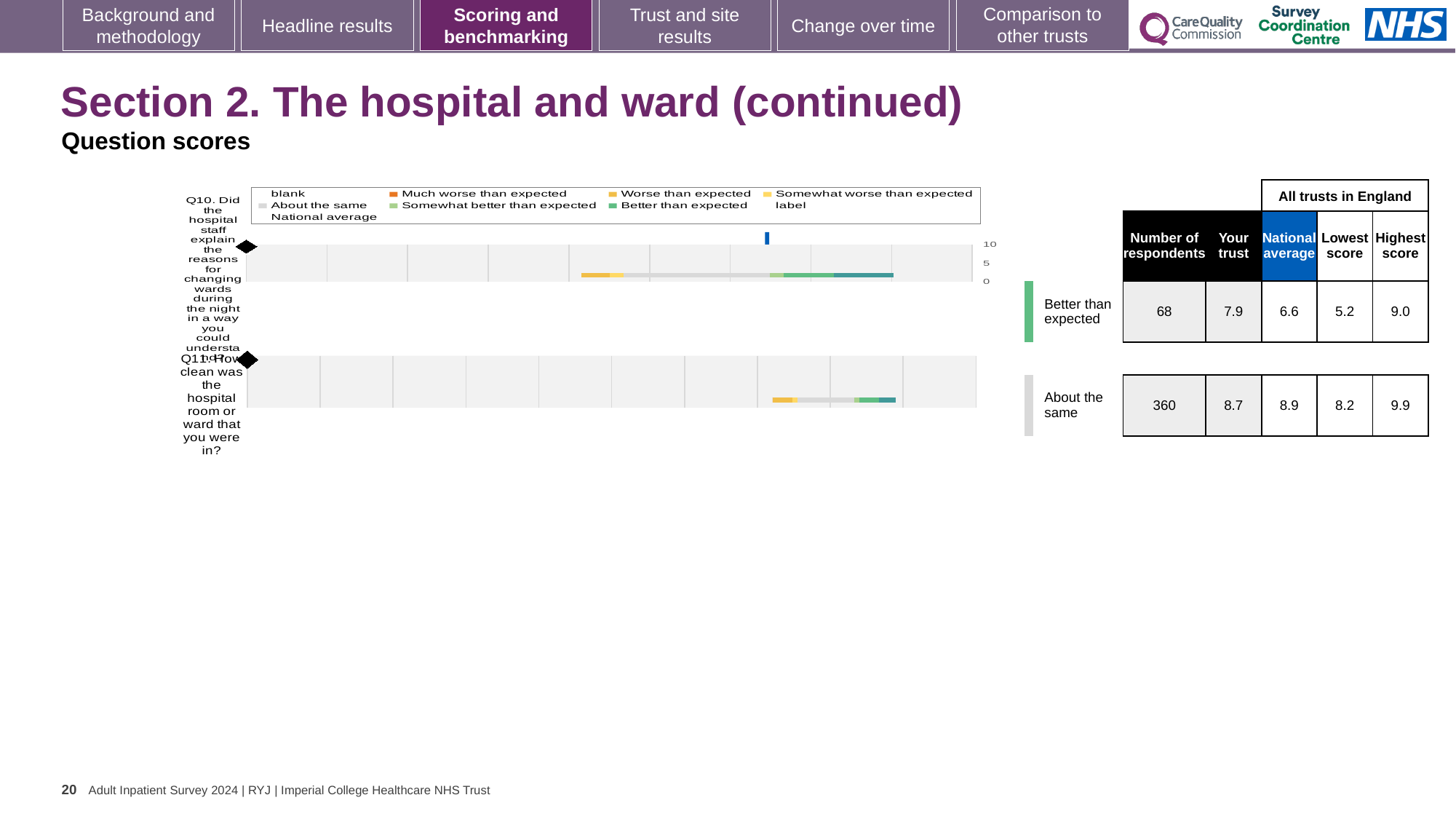
What benchmark category is shown for Q10 (explaining reasons for changing wards during the night)? Better than expected For Q11, what is the difference between the national average and the 'Your trust' score? 0.2 For Q10, which is higher: the 'Your trust' score or the national average? Your trust What is the highest score among all trusts in England for Q11 (how clean was the hospital room or ward)? 9.9 What is the 'Your trust' score for Q10 (explaining reasons for changing wards during the night)? 7.9 For Q10, what is the difference between the 'Your trust' score and the national average? 1.3 What is the lowest score among all trusts in England for Q10 (explaining reasons for changing wards during the night)? 5.2 What type of chart is used to show the question scores on this slide? Bar chart For Q10 (explaining reasons for changing wards during the night), how many respondents are shown in the table? 68 Which question has more respondents, Q10 or Q11? Q11 What is the national average score for Q11 (how clean was the hospital room or ward)? 8.9 What benchmark category is shown for Q11 (how clean was the hospital room or ward)? About the same